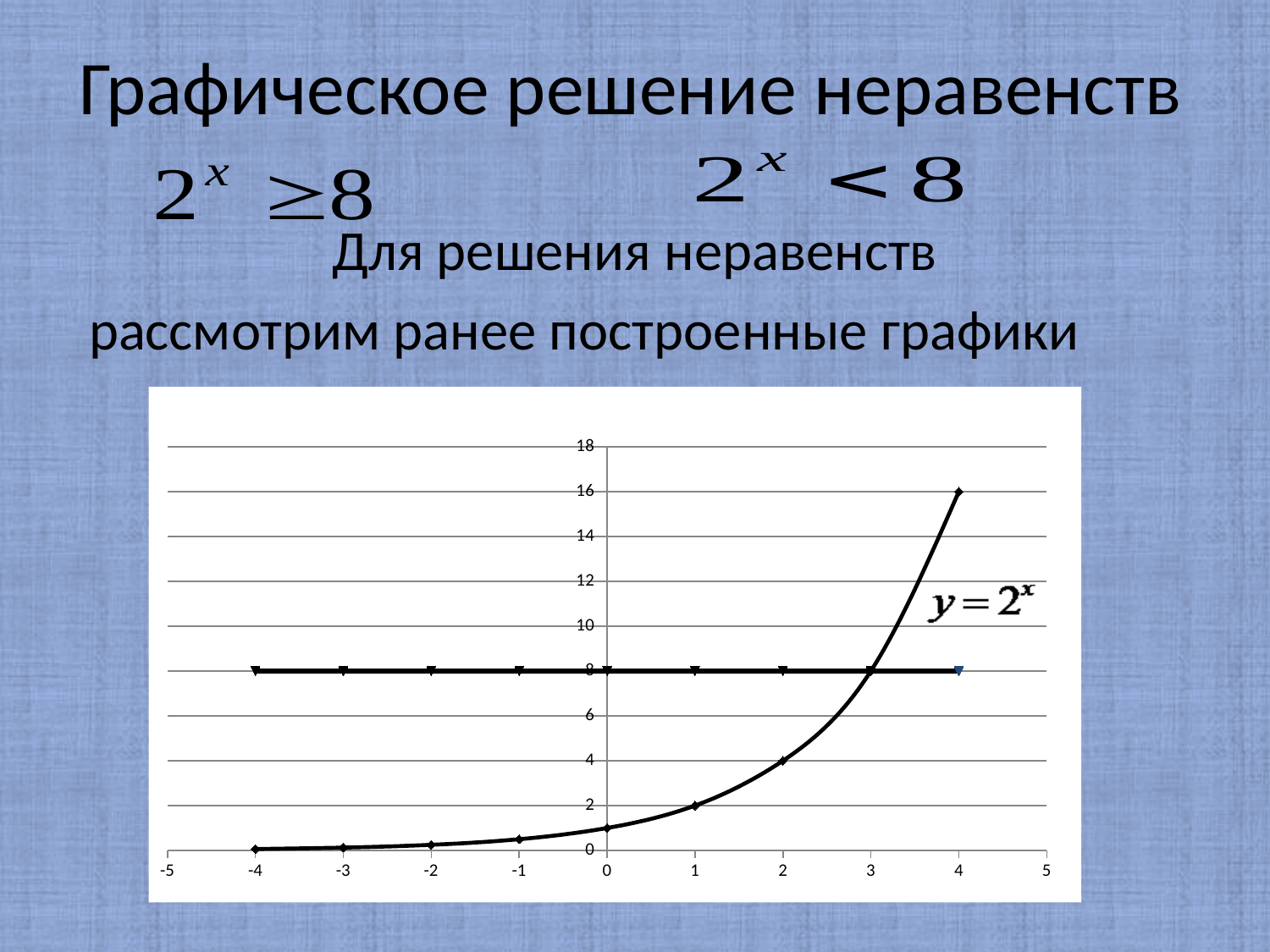
What is the value of the curve y = 2^x at x = 2? 4 What is the value of the curve y = 2^x at x = 4? 16 At what x value does the curve y = 2^x cross the horizontal line? 3 What is the value of the curve y = 2^x at x = 1? 2 What label is written next to the curve on the chart? y = 2^x Is the value of the curve y = 2^x at x = -2 greater or less than 2? less Does the curve y = 2^x rise or fall as x increases? rises At what y value is the horizontal line drawn? 8 How many marked points does the curve y = 2^x have? 9 Is the value of the curve y = 2^x at x = 3.5 greater or less than 10? greater What kind of chart is shown on the slide? line chart Which is larger: the curve y = 2^x at x = 4 or the horizontal line? the curve at x = 4